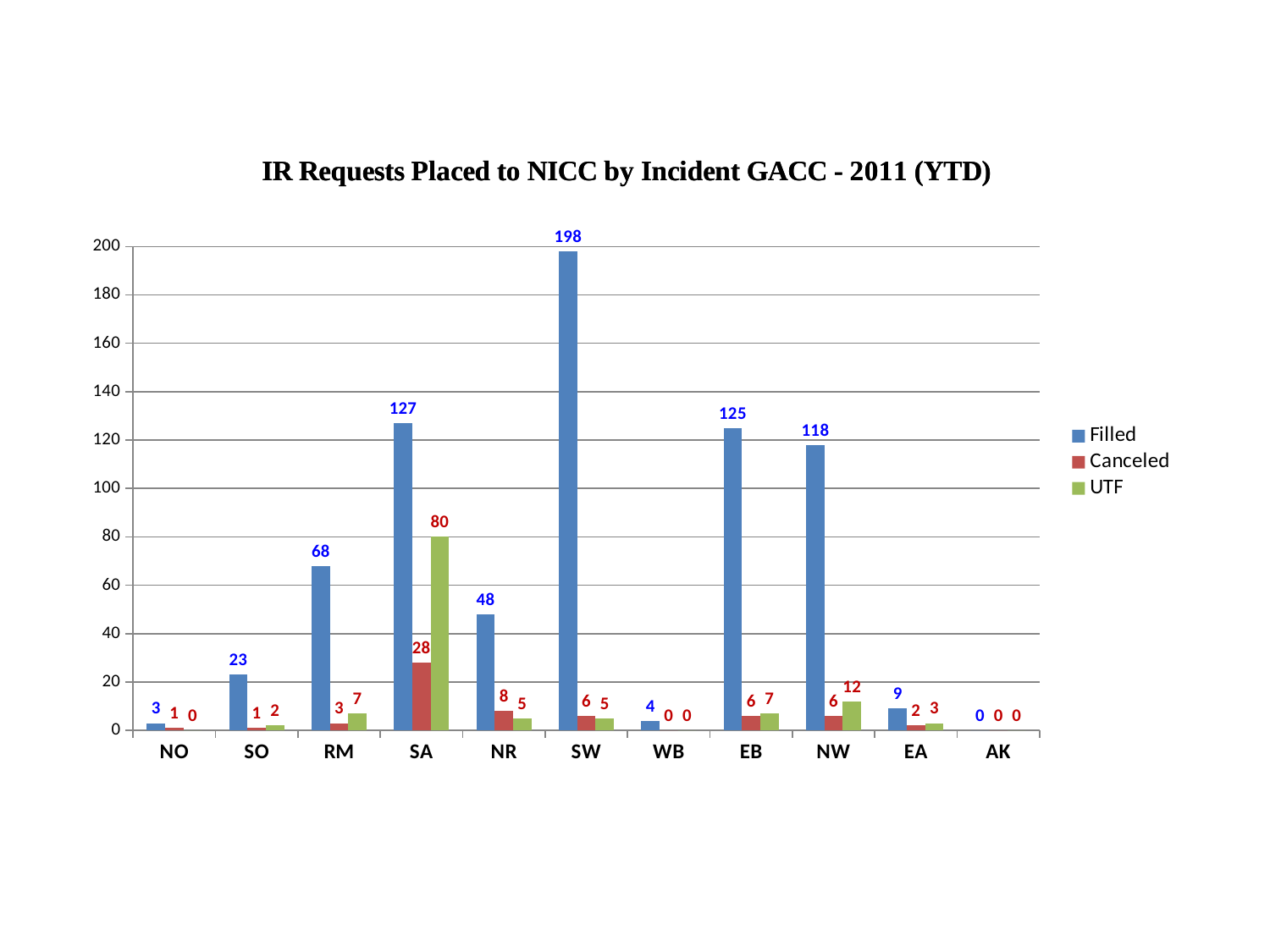
What is the Filled value for SW? 198 How many series does the legend list? 3 Which GACC has the highest Filled value? SW What is the UTF value for SA? 80 What kind of chart is shown on the slide? bar chart What is the difference between the Filled values for SW and EB? 73 Which is larger, the Filled value for RM or the Filled value for NR? RM Is the Filled value for EB greater or less than 100? greater What is the difference between the Filled values for SA and NW? 9 Which GACC has the highest UTF value? SA What is the Canceled value for NR? 8 How many GACC categories are shown on the x axis? 11